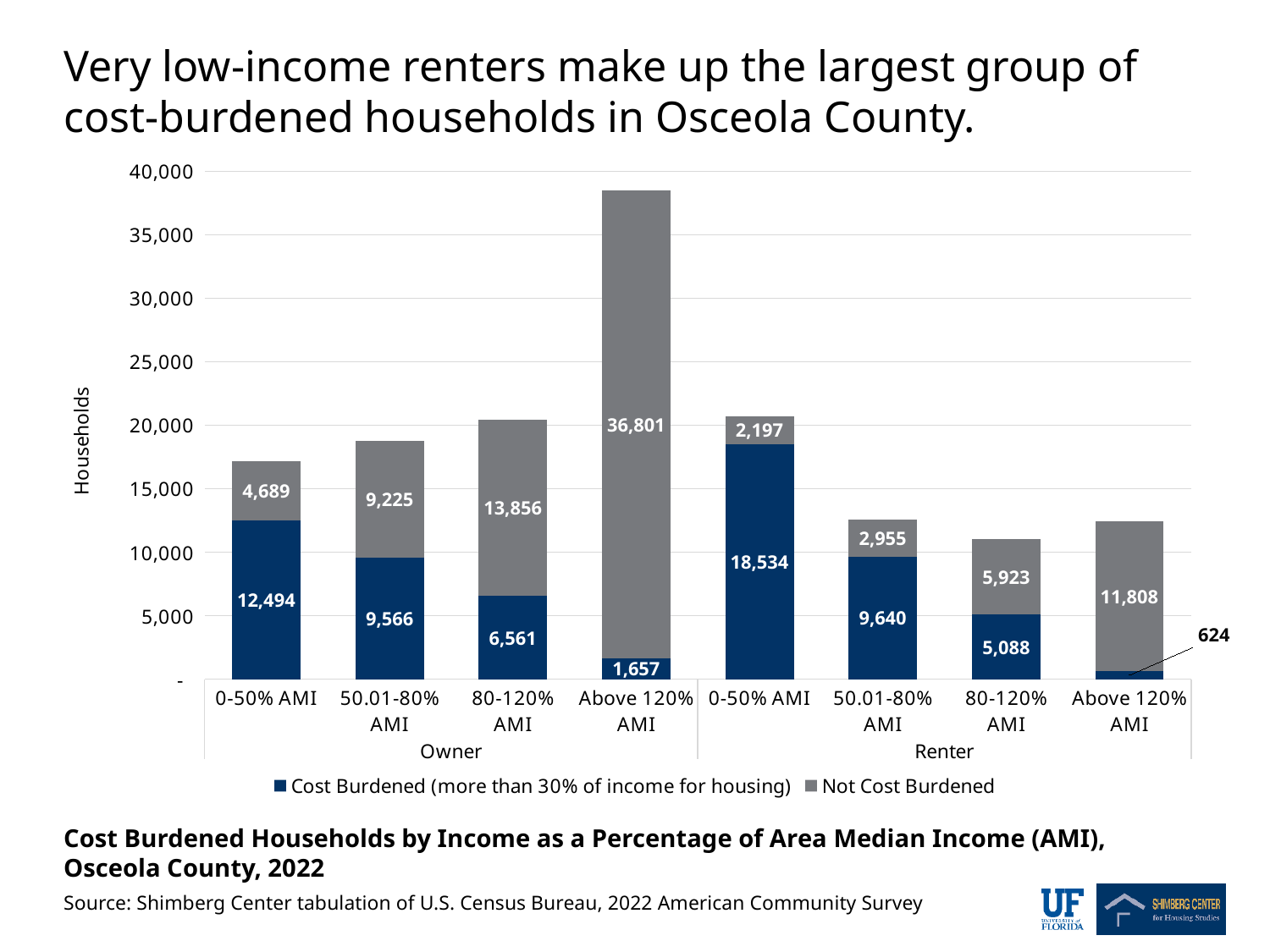
What is the number of cost-burdened renter households in the Above 120% AMI category? 624 Which is larger: the number of cost-burdened owner households at 50.01-80% AMI or the number of cost-burdened renter households at 50.01-80% AMI? Renter 50.01-80% AMI (9,640) What is the number of cost-burdened renter households in the 0-50% AMI category? 18,534 What is the number of not cost-burdened owner households in the Above 120% AMI category? 36,801 Which category has the lowest number of cost-burdened households? Renter Above 120% AMI How many income categories are plotted across the Owner and Renter groups combined? 8 Which category has the highest number of cost-burdened households? Renter 0-50% AMI What is the difference between cost-burdened owner households at 0-50% AMI and cost-burdened owner households at 80-120% AMI? 5,933 What type of chart is shown on the slide? Stacked bar chart How many series does the legend list? 2 Is the total height of the Owner Above 120% AMI bar greater or less than 35,000? greater What is the total number of households (cost burdened plus not cost burdened) in the Owner 0-50% AMI category? 17,183